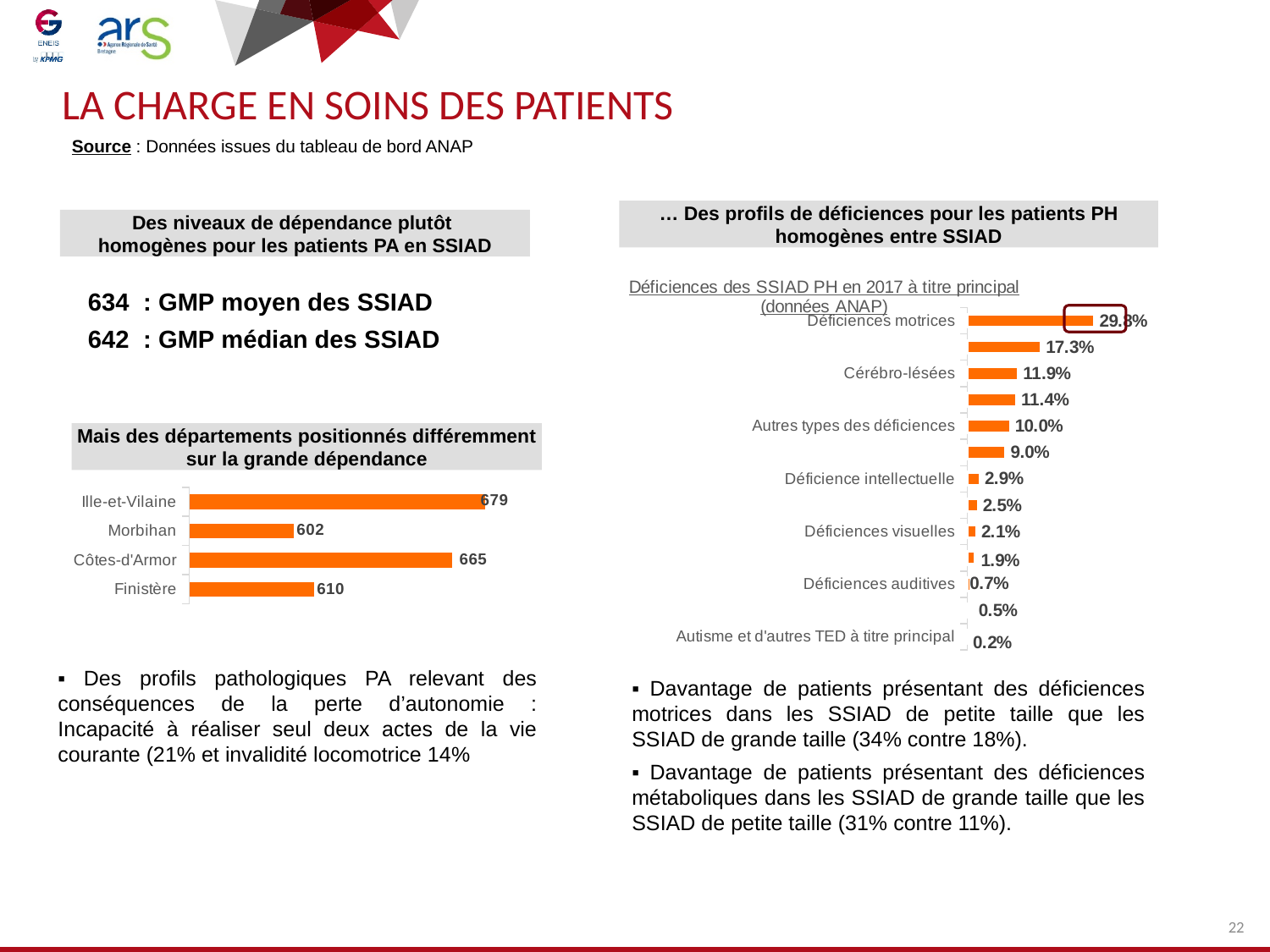
What kind of chart is the left chart of departments? Bar chart In the left chart of departments, what is the value for Morbihan? 602 In the chart 'Déficiences des SSIAD PH en 2017 à titre principal', what is the difference between the values for Autres types des déficiences and Déficiences visuelles? 7.9% In the chart 'Déficiences des SSIAD PH en 2017 à titre principal', which category has the highest value? Déficiences motrices In the left chart of departments, how many departments are shown? 4 In the left chart of departments, which is larger, the value for Côtes-d'Armor or the value for Finistère? Côtes-d'Armor In the left chart of departments, which department has the highest value? Ille-et-Vilaine In the chart 'Déficiences des SSIAD PH en 2017 à titre principal', what is the value for Cérébro-lésées? 11.9% In the chart 'Déficiences des SSIAD PH en 2017 à titre principal', what is the value for Déficience intellectuelle? 2.9% In the left chart of departments, what is the value for Ille-et-Vilaine? 679 In the left chart of departments, which department has the lowest value? Morbihan In the left chart of departments, what is the difference between the values for Côtes-d'Armor and Finistère? 55